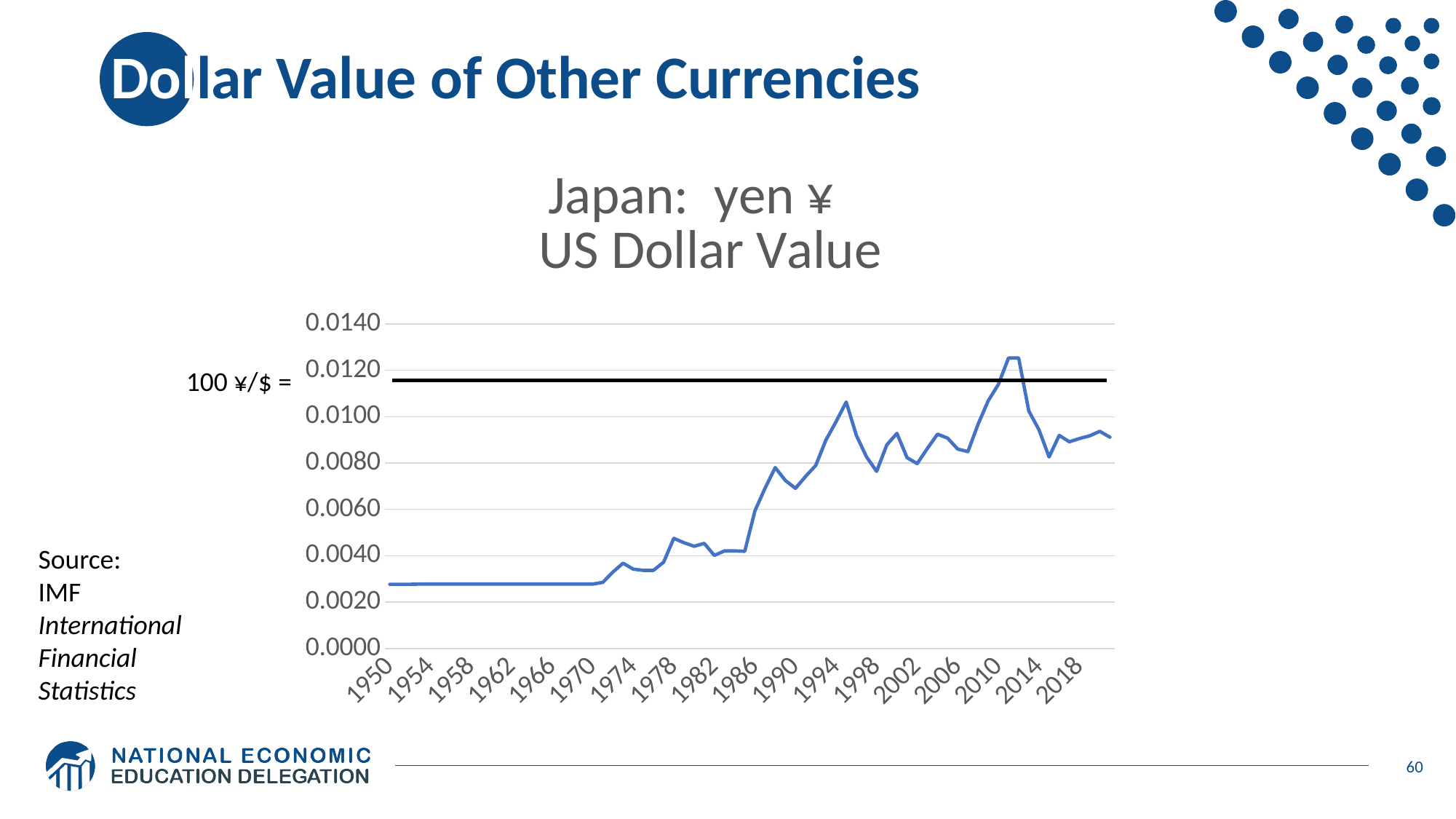
Is the value for 1978 greater or less than 0.0040? greater Overall, does the US dollar value of the yen rise or fall from 1950 to 2018? rise What kind of chart is shown on the slide? line chart Is the value for 1950 greater or less than 0.0040? less Is the value for 1970 greater or less than 0.0040? less Which is larger, the value for 1950 or the value for 2018? 2018 What is the title of the chart? Japan: yen ¥ US Dollar Value How many year labels are shown on the x axis? 18 What does the horizontal black reference line on the chart represent? 100 ¥/$